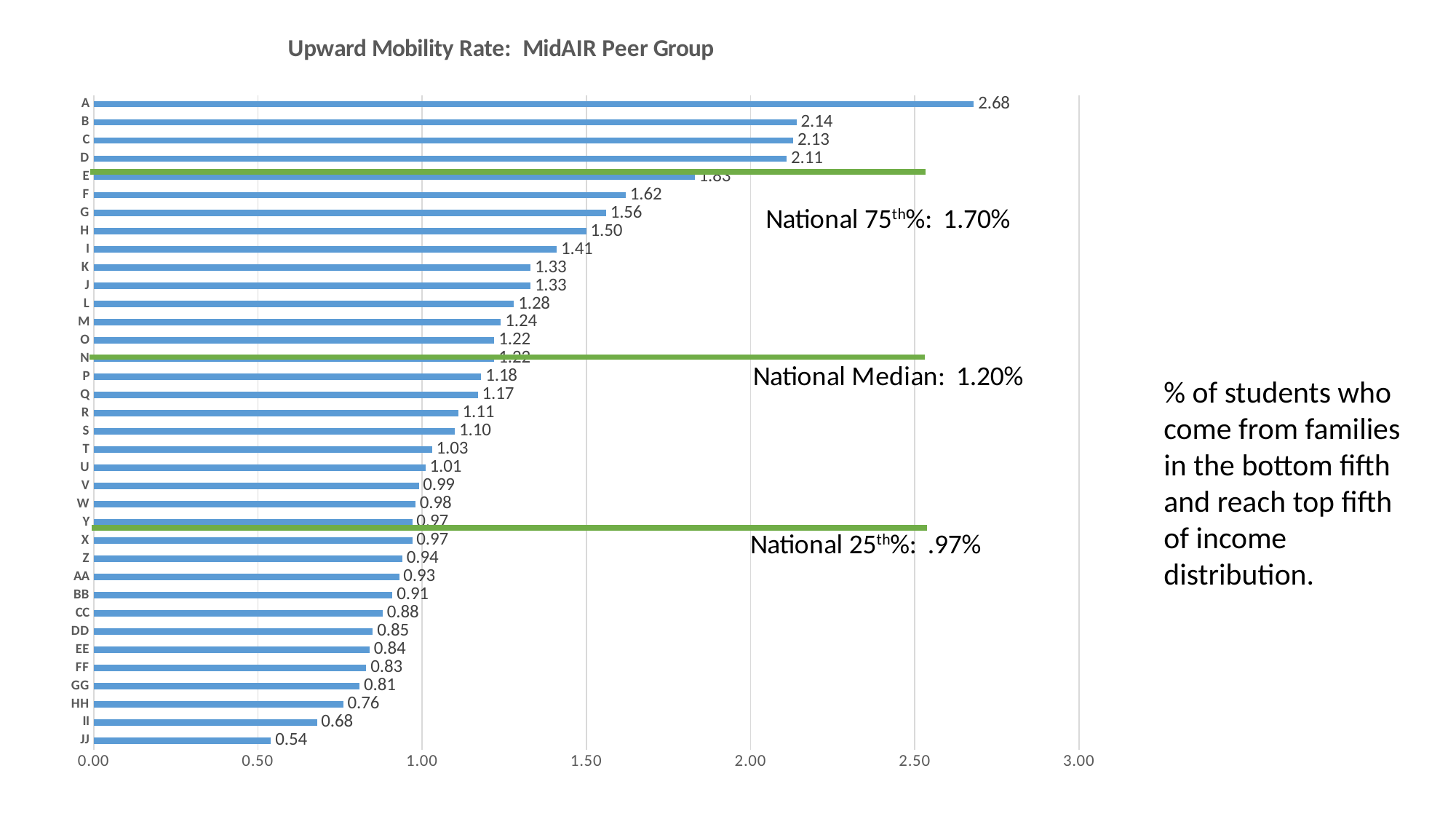
How many categories are shown on the chart? 36 Which category has the lowest value? JJ Which has a larger value, F or I? F What is the value for CC? 0.88 Is the value for D greater or less than 2.00? greater What is the value for JJ? 0.54 What is the title of the chart? Upward Mobility Rate: MidAIR Peer Group What kind of chart is this? Bar chart What is the value for A? 2.68 What is the value for H? 1.50 What is the difference between the values for A and B? 0.54 Which category has the highest value? A